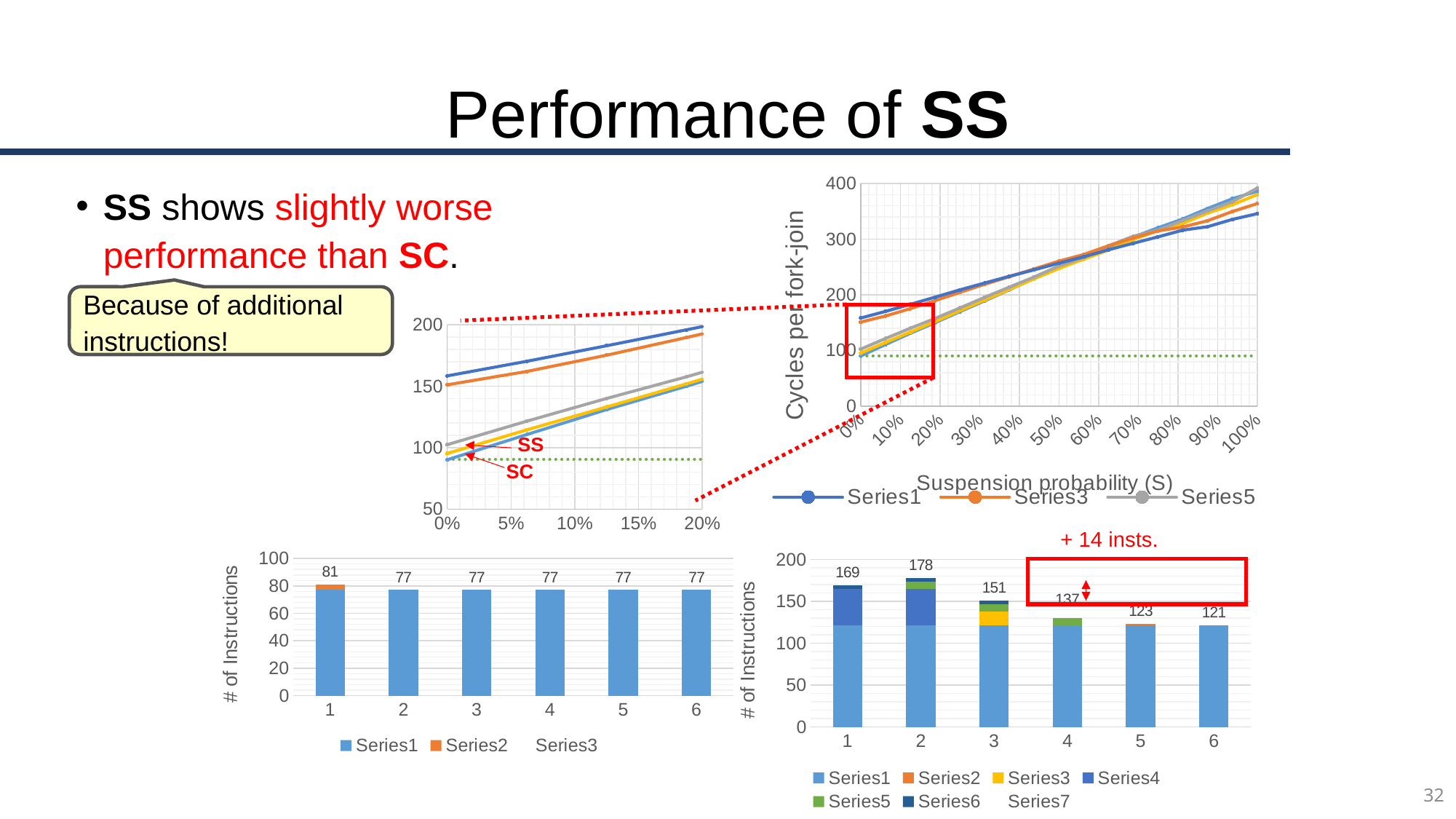
In the bottom-right bar chart, what is the difference between the totals for category 4 and category 5? 14 How many series does the legend of the bottom-right bar chart list? 7 What kind of chart is the top-right chart titled with the y axis 'Cycles per fork-join'? line chart In the bottom-left bar chart, what is the total number of instructions for category 1? 81 How many categories are shown on the x axis of the bottom-right bar chart? 6 In the top-right line chart, do the cycles per fork-join rise or fall as the suspension probability increases from 0% to 100%? rise In the bottom-left bar chart, which category has the highest total? 1 In the bottom-right bar chart, which category has the lowest total? 6 In the bottom-left bar chart, what is the difference between the totals for category 1 and category 2? 4 In the bottom-right bar chart, what is the total number of instructions for category 4? 137 How many series does the legend of the bottom-left bar chart list? 3 In the bottom-right bar chart, which category has the highest total? 2